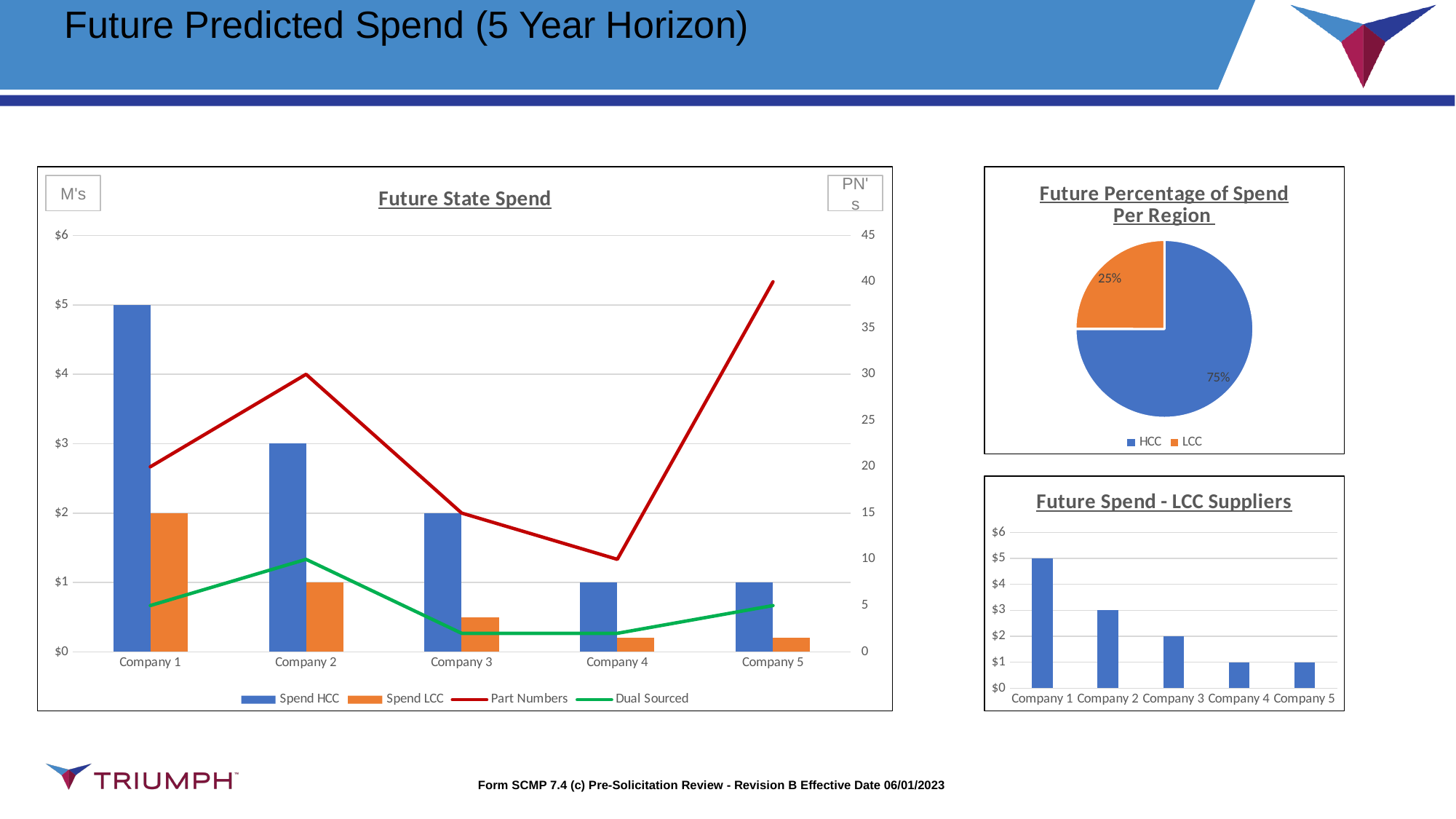
In the Future Spend - LCC Suppliers chart, what is the value for Company 1? $5 In the Future State Spend chart, which company has the highest Spend HCC? Company 1 In the Future State Spend chart, how many series does the legend list? 4 What kind of chart is Future Percentage of Spend Per Region? pie chart In the Future State Spend chart, what is the Spend HCC value for Company 1? $5 In the Future State Spend chart, which is larger, the Spend HCC for Company 2 or for Company 3? Company 2 In the Future Percentage of Spend Per Region chart, what share of spend is HCC? 75% In the Future Spend - LCC Suppliers chart, do the values rise or fall from Company 1 to Company 5? fall In the Future State Spend chart, what is the difference between the Spend HCC for Company 1 and Company 2? $2 In the Future State Spend chart, is the Spend LCC value for Company 3 greater or less than $1? less In the Future State Spend chart, what is the Spend LCC value for Company 1? $2 In the Future State Spend chart, which company has the highest Part Numbers value? Company 5